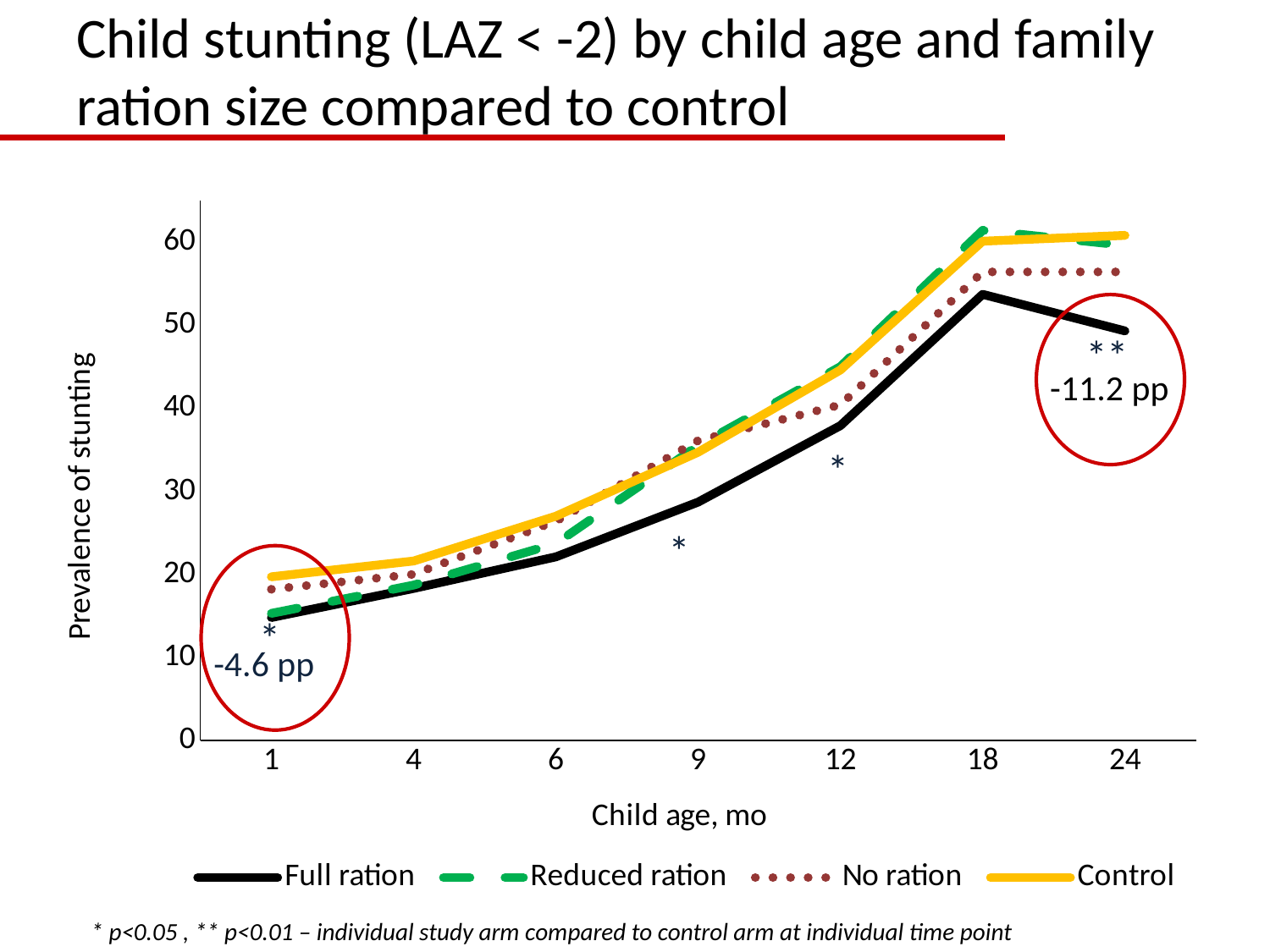
Is the No ration value at 24 months greater or less than 50? greater Is the Full ration value at 18 months greater or less than 50? greater What percentage-point difference is annotated at 1 month? -4.6 pp At 24 months, which is larger: the Full ration value or the Control value? Control At 12 months, which is larger: the Full ration value or the No ration value? No ration How many child age points are shown on the x axis? 7 What percentage-point difference is annotated at 24 months? -11.2 pp Which series has the lowest prevalence of stunting at 24 months? Full ration Which series has the lowest prevalence of stunting at 12 months? Full ration How many series does the legend list? 4 Is the Full ration value at 12 months greater or less than 40? less What kind of chart is shown on the slide? line chart